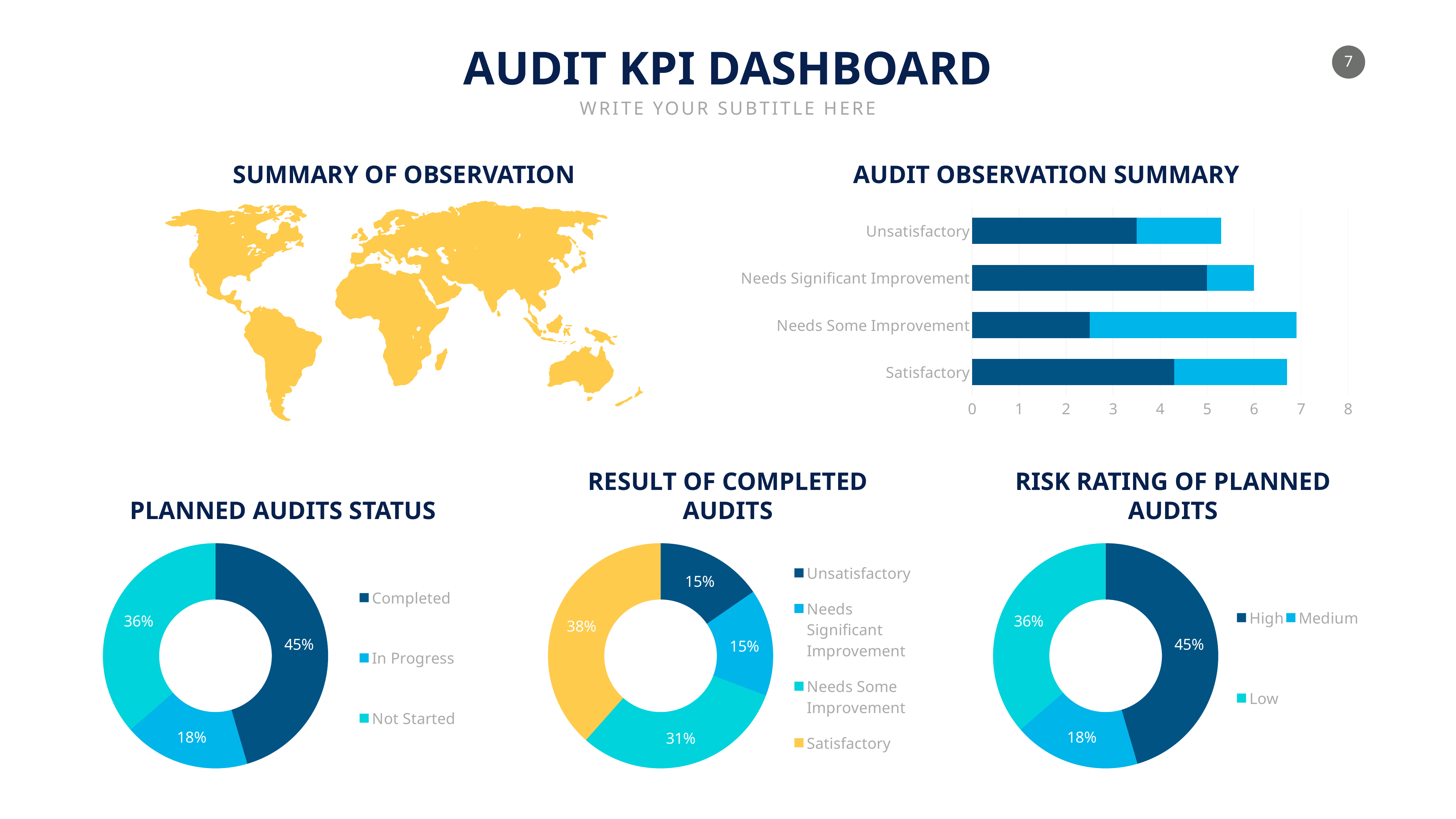
In the Audit Observation Summary chart, is the total bar length for Unsatisfactory greater or less than 6? less How many categories does the Result of Completed Audits chart show? 4 In the Result of Completed Audits chart, what percentage of audits were rated Needs Some Improvement? 31% In the Planned Audits Status chart, what percentage of audits are Completed? 45% In the Result of Completed Audits chart, what percentage of audits were Satisfactory? 38% In the Planned Audits Status chart, what is the difference in percentage points between Completed and In Progress? 27 In the Result of Completed Audits chart, which result has the largest share? Satisfactory In the Risk Rating of Planned Audits chart, which is larger, the High share or the Low share? High In the Risk Rating of Planned Audits chart, what percentage of audits are rated Medium? 18% What kind of chart is the Audit Observation Summary chart? Stacked bar chart In the Planned Audits Status chart, what percentage of audits are Not Started? 36% In the Planned Audits Status chart, which status has the smallest share? In Progress